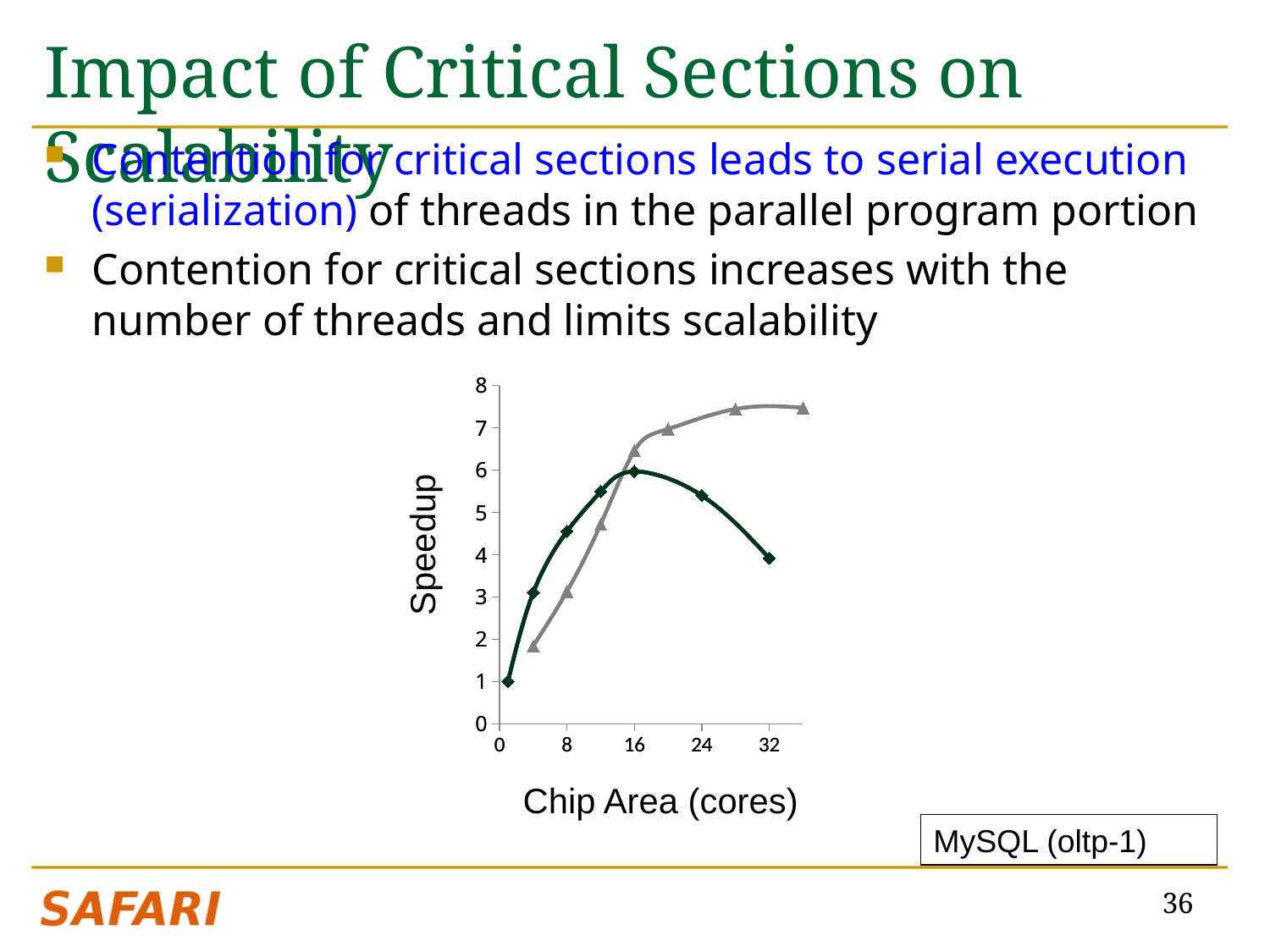
At 24 cores, which line has the higher speedup, the dark green diamond line or the gray triangle line? the gray triangle line How many lines (series) are plotted on the chart? 2 Is the speedup of the dark green diamond line at 16 cores greater or less than 5? greater At 8 cores, which line has the higher speedup, the dark green diamond line or the gray triangle line? the dark green diamond line Is the speedup of the gray triangle line at 4 cores greater or less than 3? less Does the speedup of the dark green diamond line keep rising as chip area increases, or does it rise and then fall? rises and then falls What is the speedup of the first point of the dark green diamond line, at chip area 1 core? 1 What is the label of the y axis of the chart? Speedup What kind of chart is shown on the slide? line chart Is the speedup of the gray triangle line at its rightmost point greater or less than 7? greater What is the label of the x axis of the chart? Chip Area (cores)